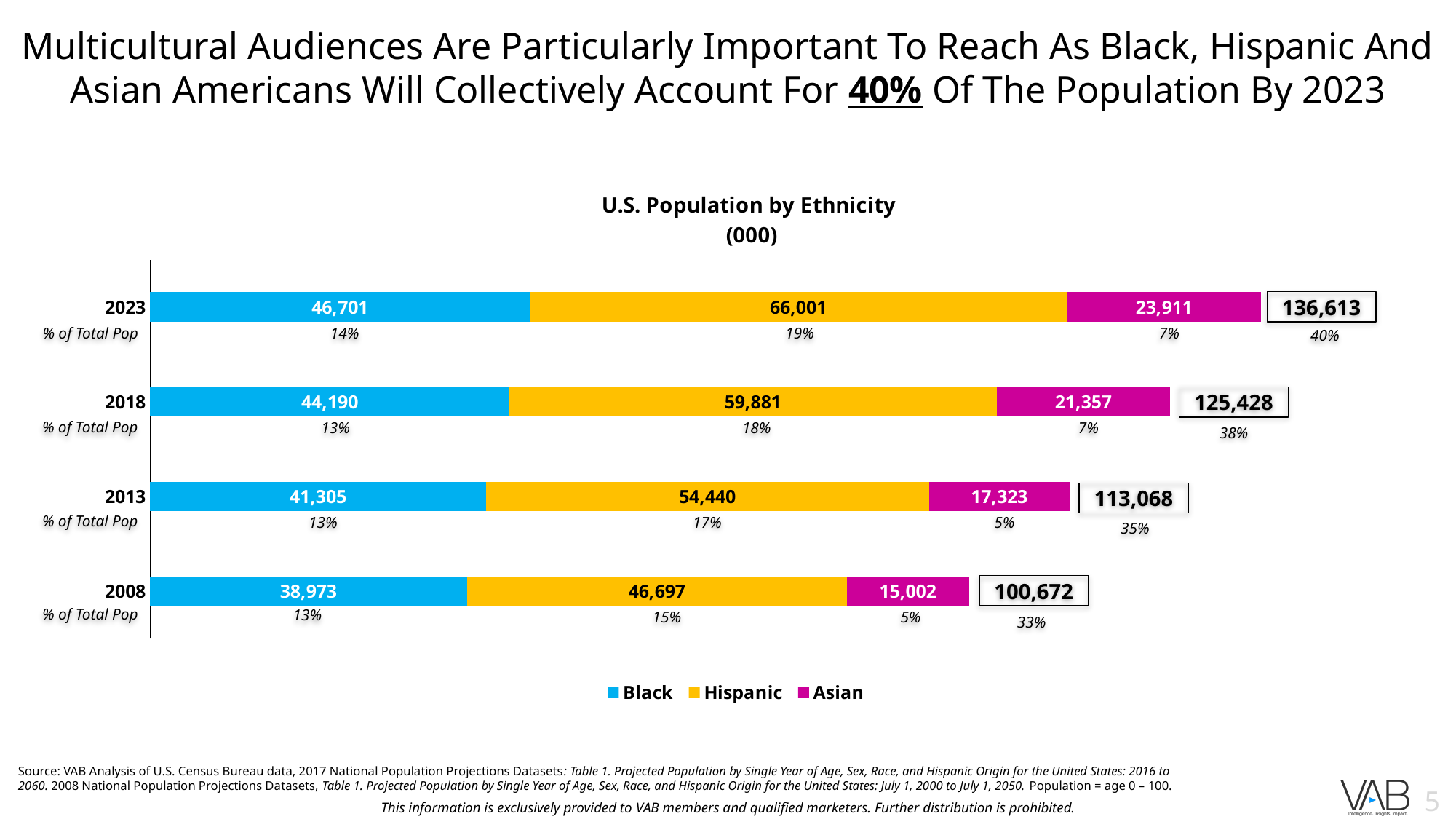
What is the Asian value for 2013? 17,323 How many series does the legend list? 3 Which year has the lowest Asian value? 2008 How many years are shown in the chart? 4 What is the Hispanic value for 2023 in the U.S. Population by Ethnicity chart? 66,001 What is the difference between the Hispanic values for 2023 and 2018? 6,120 What colour represents Asian in the chart? Magenta What kind of chart is shown? Stacked bar chart Which is larger, the Black value for 2013 or the Hispanic value for 2008? Hispanic value for 2008 Which year has the highest total? 2023 What is the Black value for 2008? 38,973 What is the total shown for the 2018 bar? 125,428